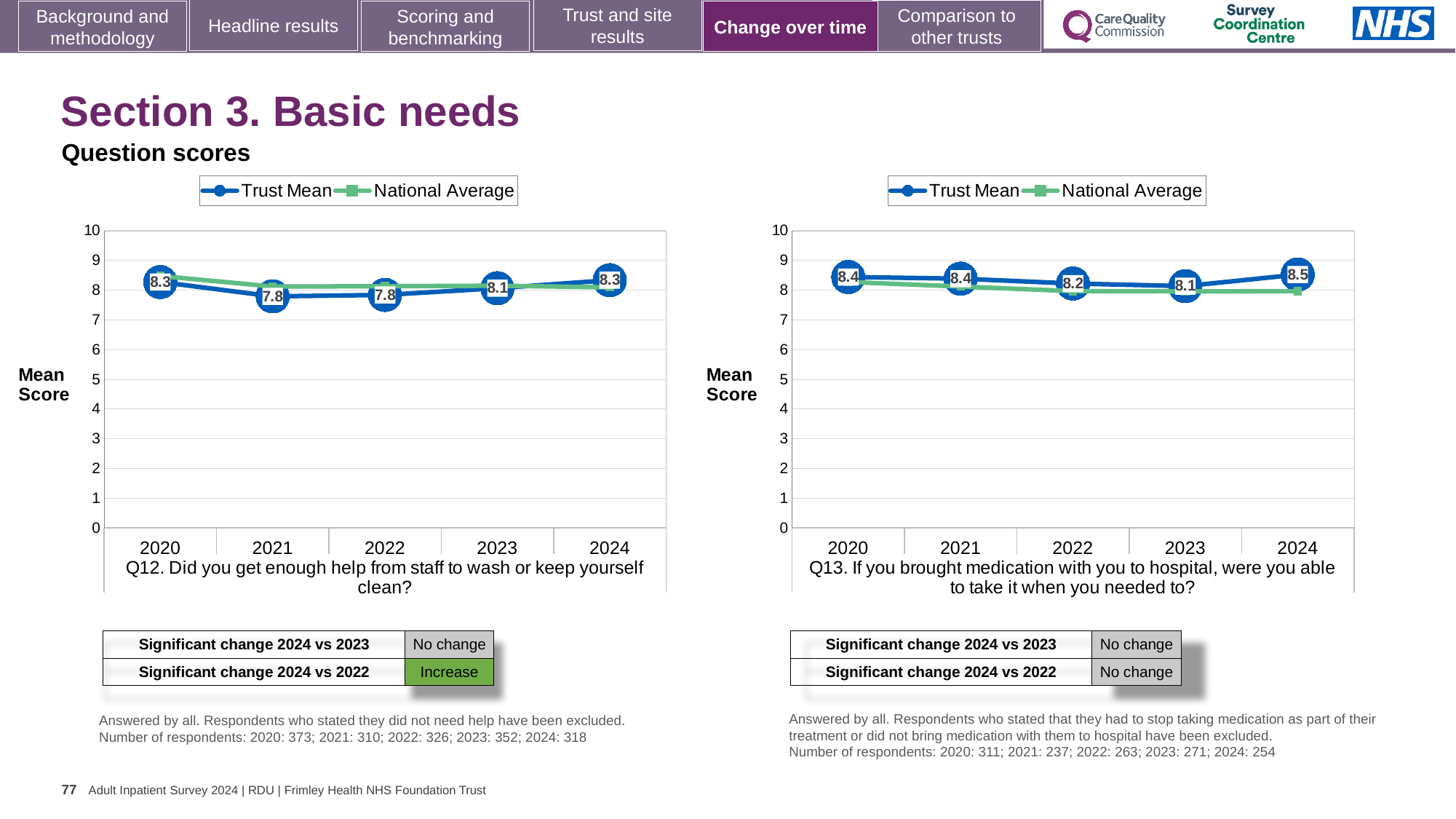
In the Q12 chart (left), what is the difference between the Trust Mean for 2024 and for 2022? 0.5 In the Q13 chart (right), what is the Trust Mean for 2023? 8.1 In the Q13 chart (right), what is the difference between the Trust Mean for 2024 and for 2023? 0.4 How many series does the legend of the Q12 chart (left) list? 2 In the Q12 chart (left), what is the Trust Mean for 2024? 8.3 In the Q12 chart (left), is the Trust Mean for 2023 higher or lower than for 2022? higher In the Q13 chart (right), which year has the lowest Trust Mean? 2023 In the Q12 chart (left), is the National Average for 2020 greater or less than 7? greater In the Q13 chart (right), what is the Trust Mean for 2024? 8.5 How many years are plotted on the x axis of the Q13 chart (right)? 5 In the Q13 chart (right), which year has the highest Trust Mean? 2024 In the Q12 chart (left), what is the Trust Mean for 2021? 7.8